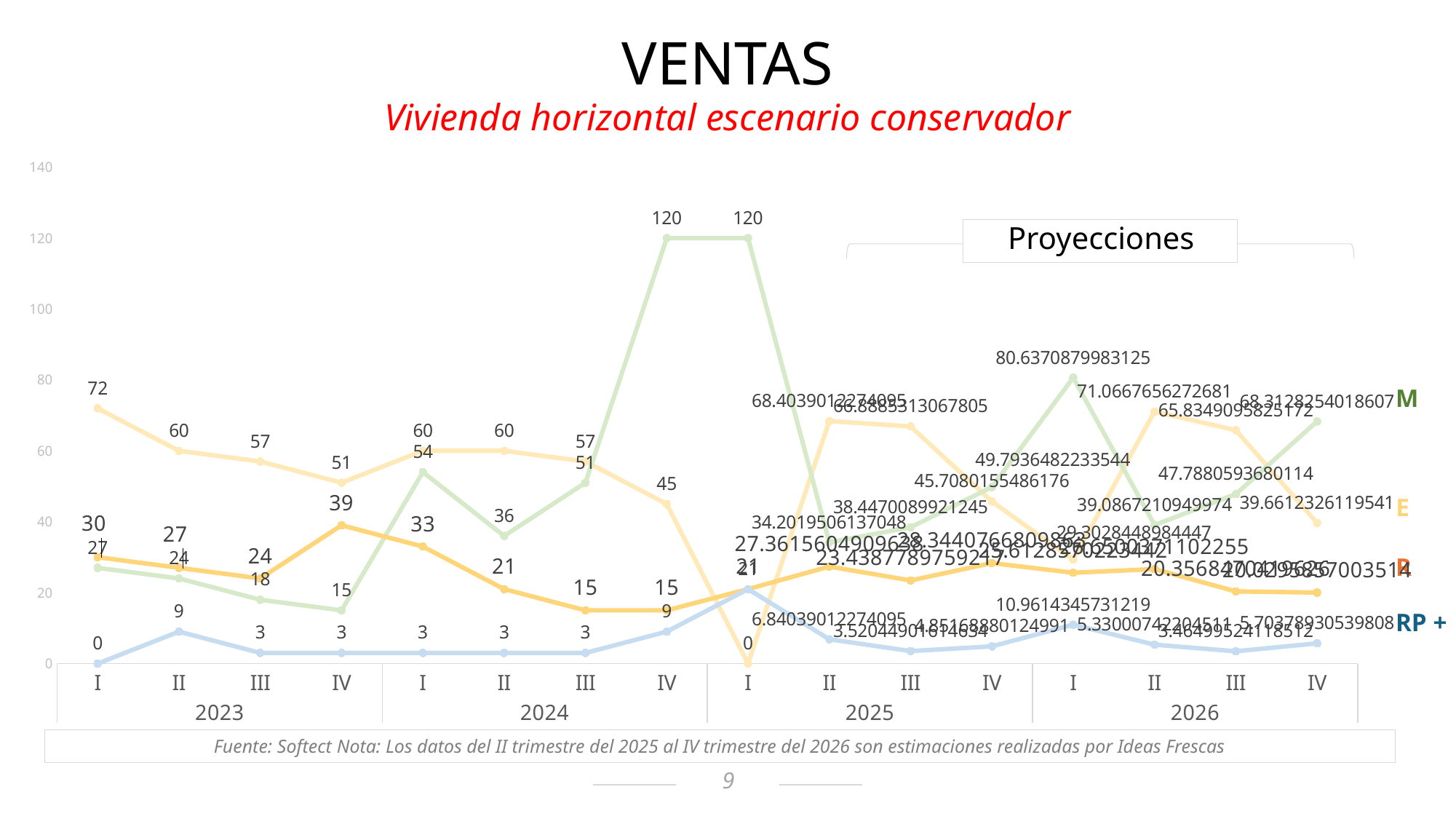
What is the value of the P series in quarter IV of 2023? 39 What is the value of the E series in quarter I of 2023? 72 What is the difference between the E series values in quarter I and quarter II of 2023? 12 What is the value of the RP + series in quarter I of 2025? 21 How many quarters are shown along the x axis? 16 What is the highest value reached by the M series? 120 How many series are plotted on the chart? 4 Does the E series rise or fall across the four quarters of 2023? fall In quarter I of 2023, which series has the larger value, E or P? E What kind of chart is shown on the slide? line chart What is the value of the M series in quarter IV of 2024? 120 Is the value of the M series in quarter I of 2026 greater or less than 60? greater